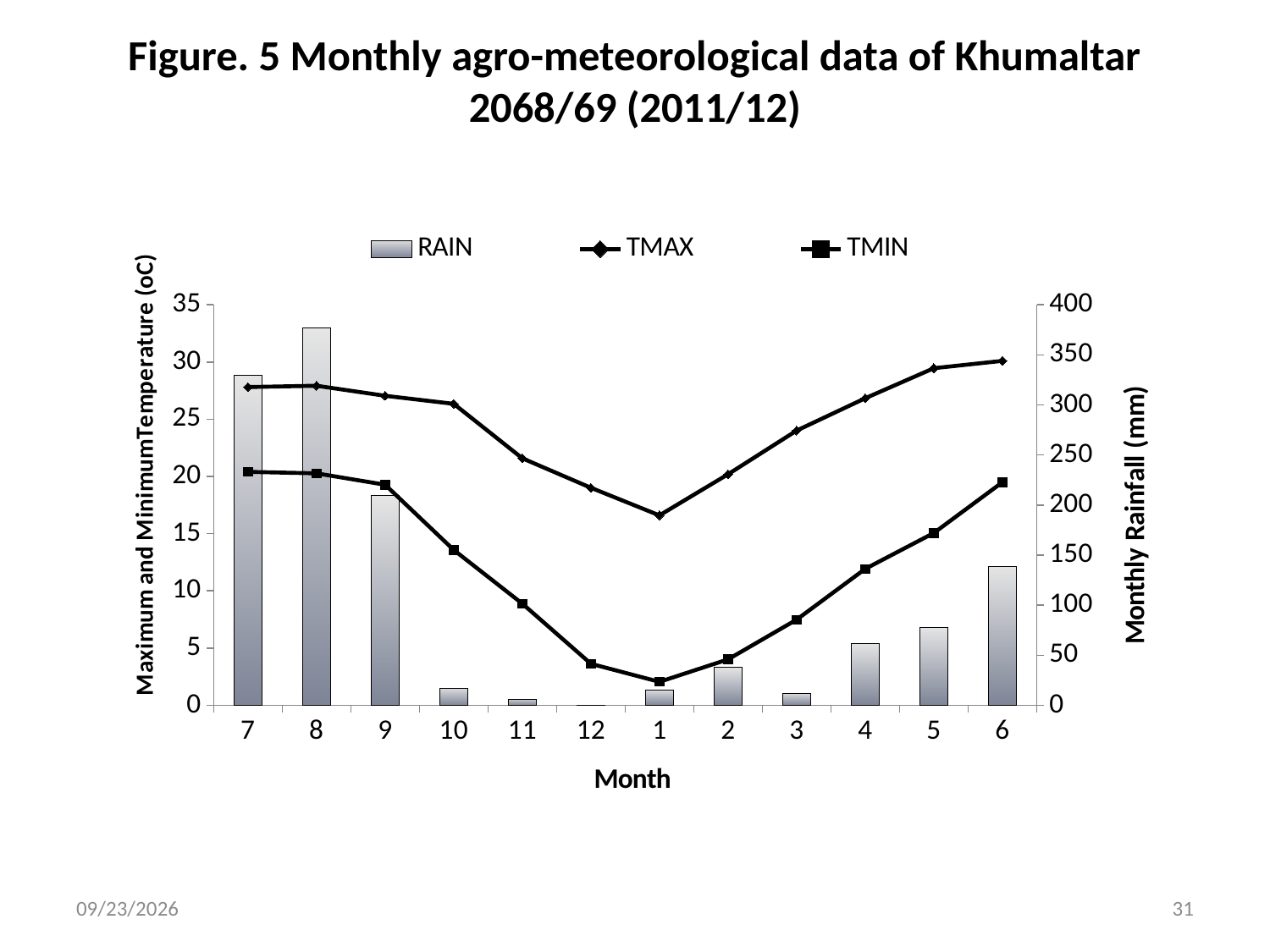
Which month has more rainfall, month 9 or month 6? 9 What kind of chart is shown on the slide? A combination bar and line chart Which month has the highest RAIN bar? 8 Is the RAIN value for month 8 greater or less than 350? greater In which month is TMAX lowest? 1 Does TMAX rise or fall from month 1 to month 6? rises In which month is TMAX highest? 6 How many series does the legend list? 3 Is the TMAX value for month 1 greater or less than 20? less In which month is TMIN lowest? 1 How many months are plotted along the x axis? 12 Is the TMIN value for month 12 greater or less than 5? less